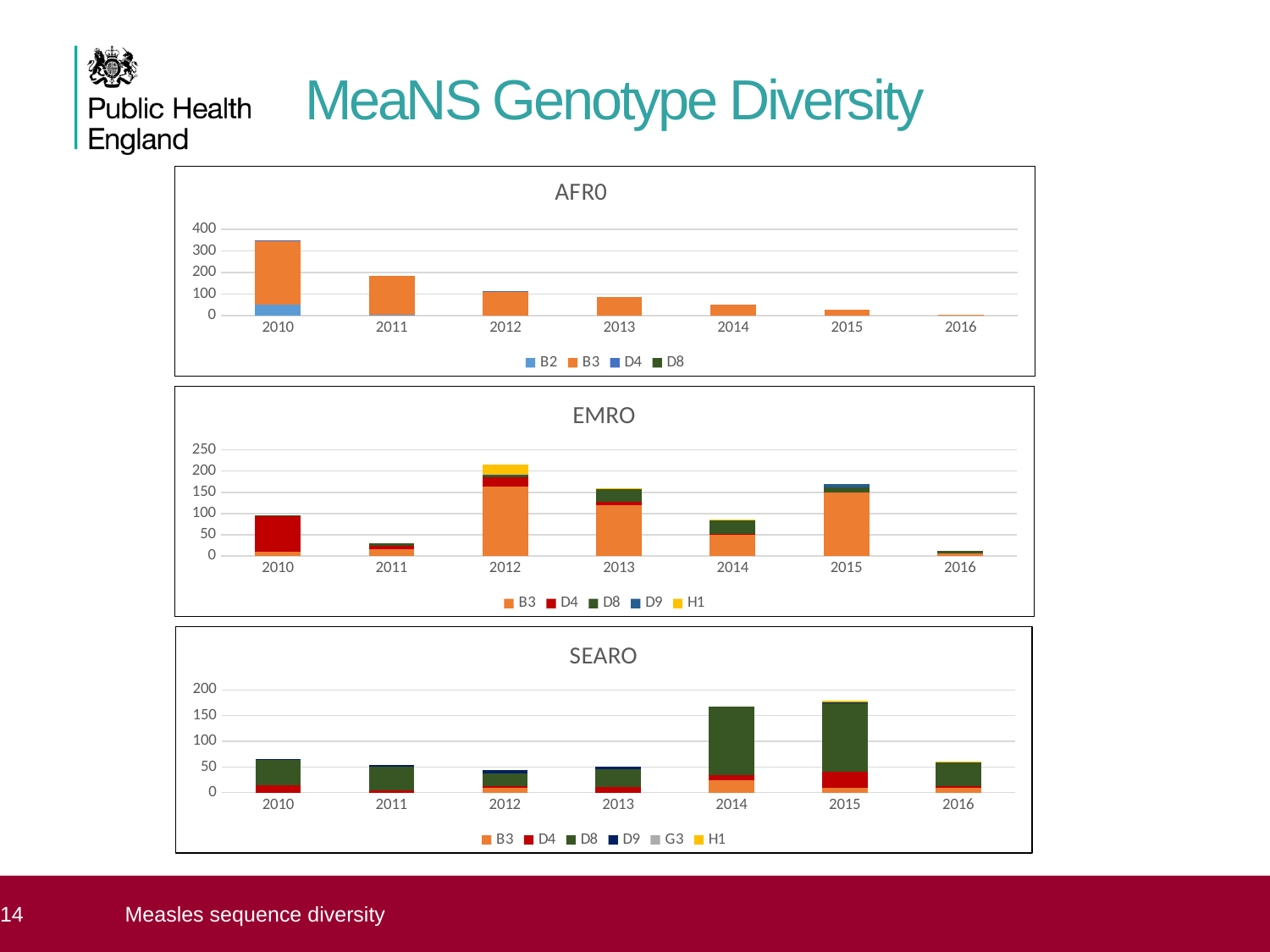
In the EMRO chart, which year has the tallest stacked bar? 2012 How many genotypes does the legend of the AFR0 chart list? 4 In the AFR0 chart, is the total for 2014 greater or less than 100? less How many genotypes does the legend of the EMRO chart list? 5 In the AFR0 chart, do the bar totals rise or fall from 2010 to 2016? fall In the AFR0 chart, is the total for 2010 greater or less than 300? greater How many genotypes does the legend of the SEARO chart list? 6 In the AFR0 chart, which year has the shortest stacked bar? 2016 In the AFR0 chart, which year has the tallest stacked bar? 2010 In the SEARO chart, is the total for 2014 greater or less than 150? greater In the EMRO chart, which year has the shortest stacked bar? 2016